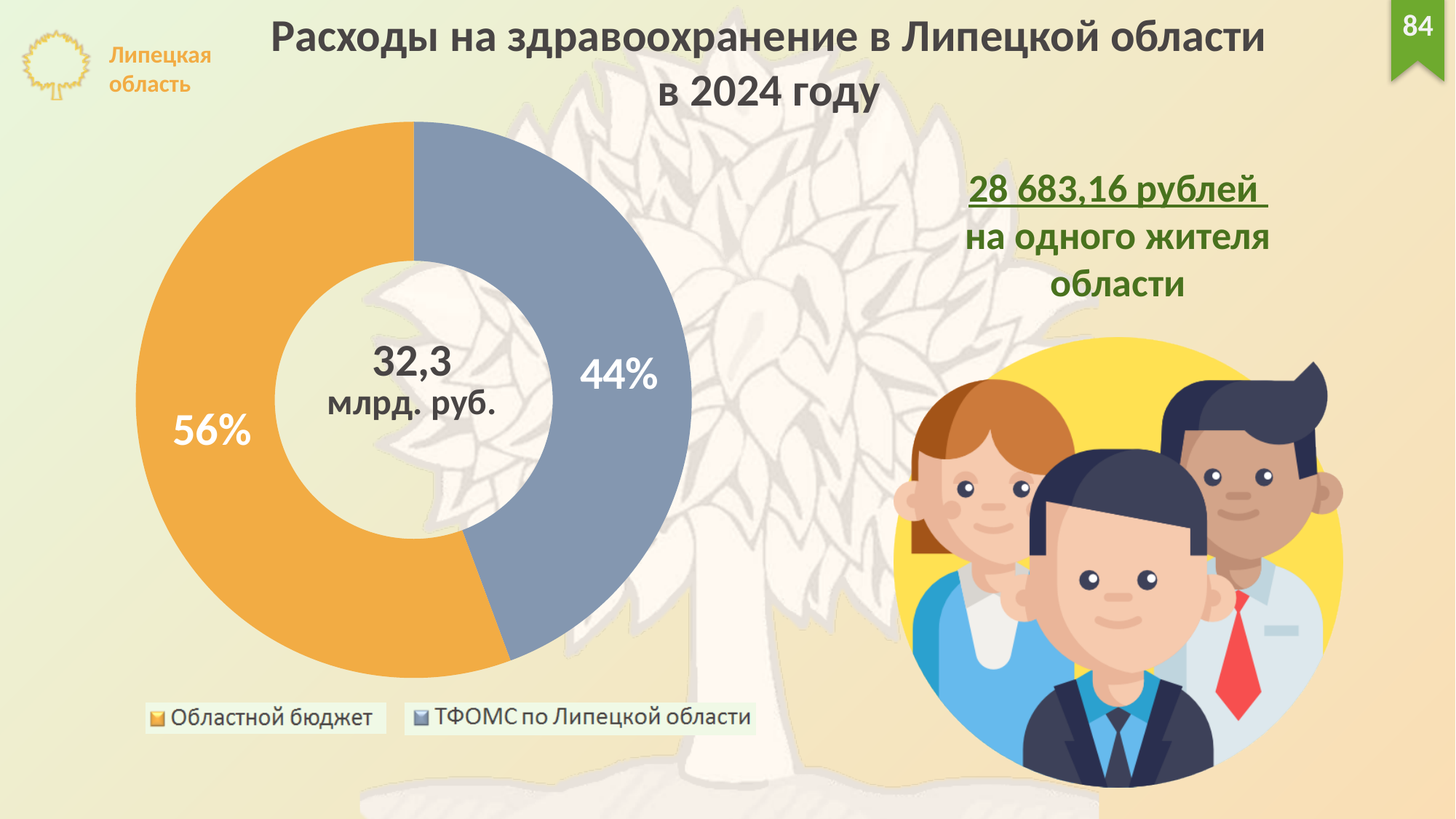
What colour represents Областной бюджет in the chart? Orange What kind of chart is shown on the slide? Doughnut (pie) chart What share of the chart does ТФОМС по Липецкой области account for? 44% What total value is printed in the centre of the chart? 32,3 млрд. руб. What is the title of the slide containing the chart? Расходы на здравоохранение в Липецкой области в 2024 году How many categories does the chart show? 2 Is the share for ТФОМС по Липецкой области greater or less than 50%? less What share of the chart does Областной бюджет account for? 56% Which is larger: the share for Областной бюджет or the share for ТФОМС по Липецкой области? Областной бюджет What is the difference in percentage points between the Областной бюджет share and the ТФОМС по Липецкой области share? 12 Which category has the largest share in the chart? Областной бюджет Which category has the smallest share in the chart? ТФОМС по Липецкой области